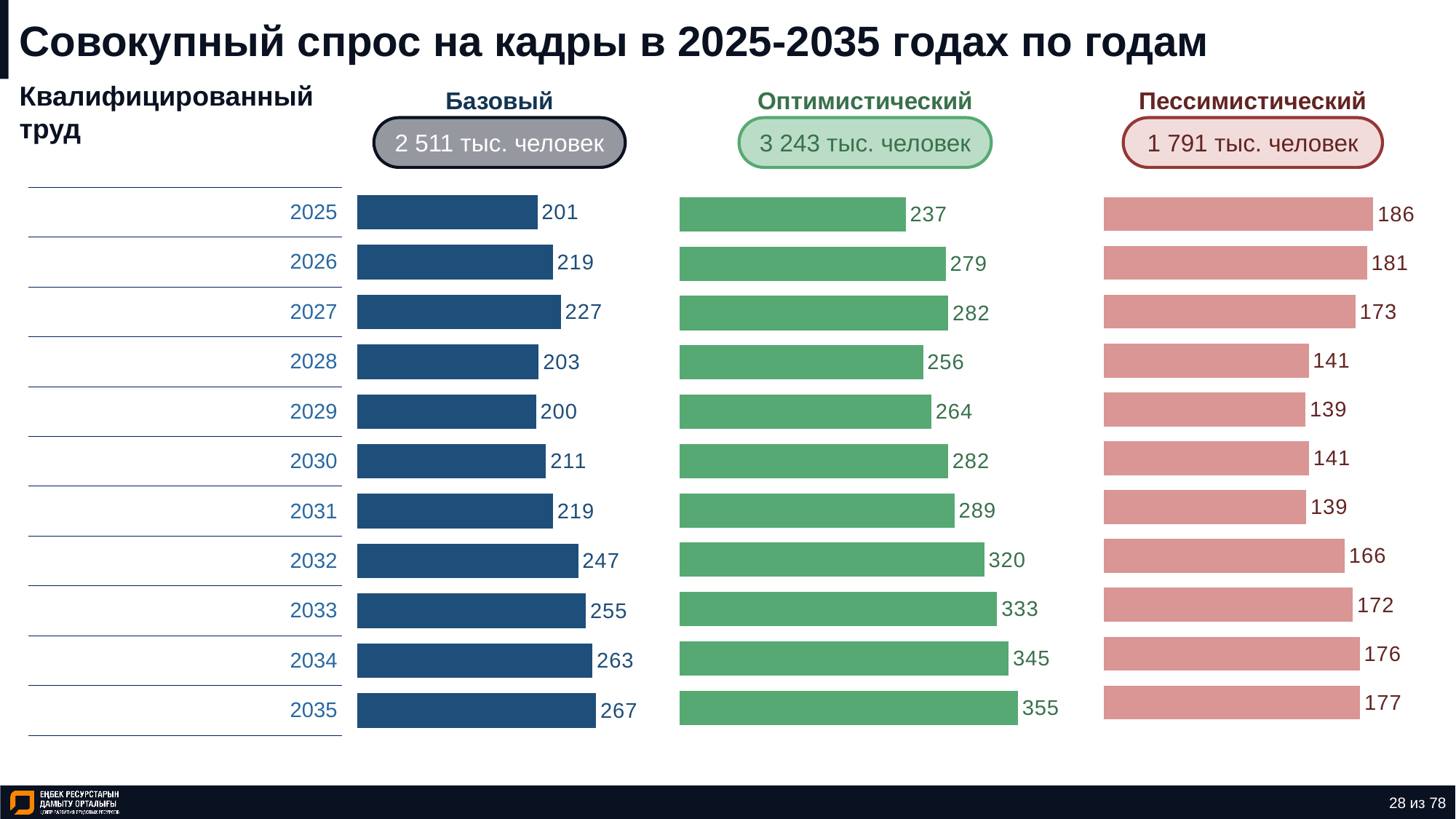
In the Базовый chart, which year has the lowest value? 2029 In the Пессимистический chart, what is the value for 2028? 141 What type of chart is used for the Оптимистический scenario? Bar chart What total is shown in the rounded label above the Пессимистический chart? 1 791 тыс. человек How many years are shown in the Базовый chart? 11 In the Оптимистический chart, what is the value for 2032? 320 In the Базовый chart, which year has the highest value? 2035 In the Базовый chart, what is the value for 2027? 227 In the Оптимистический chart, which year has the lowest value? 2025 In the Пессимистический chart, which is larger: the value for 2026 or the value for 2033? 2026 In the Оптимистический chart, what is the difference between the values for 2035 and 2025? 118 In the Пессимистический chart, which year has the highest value? 2025